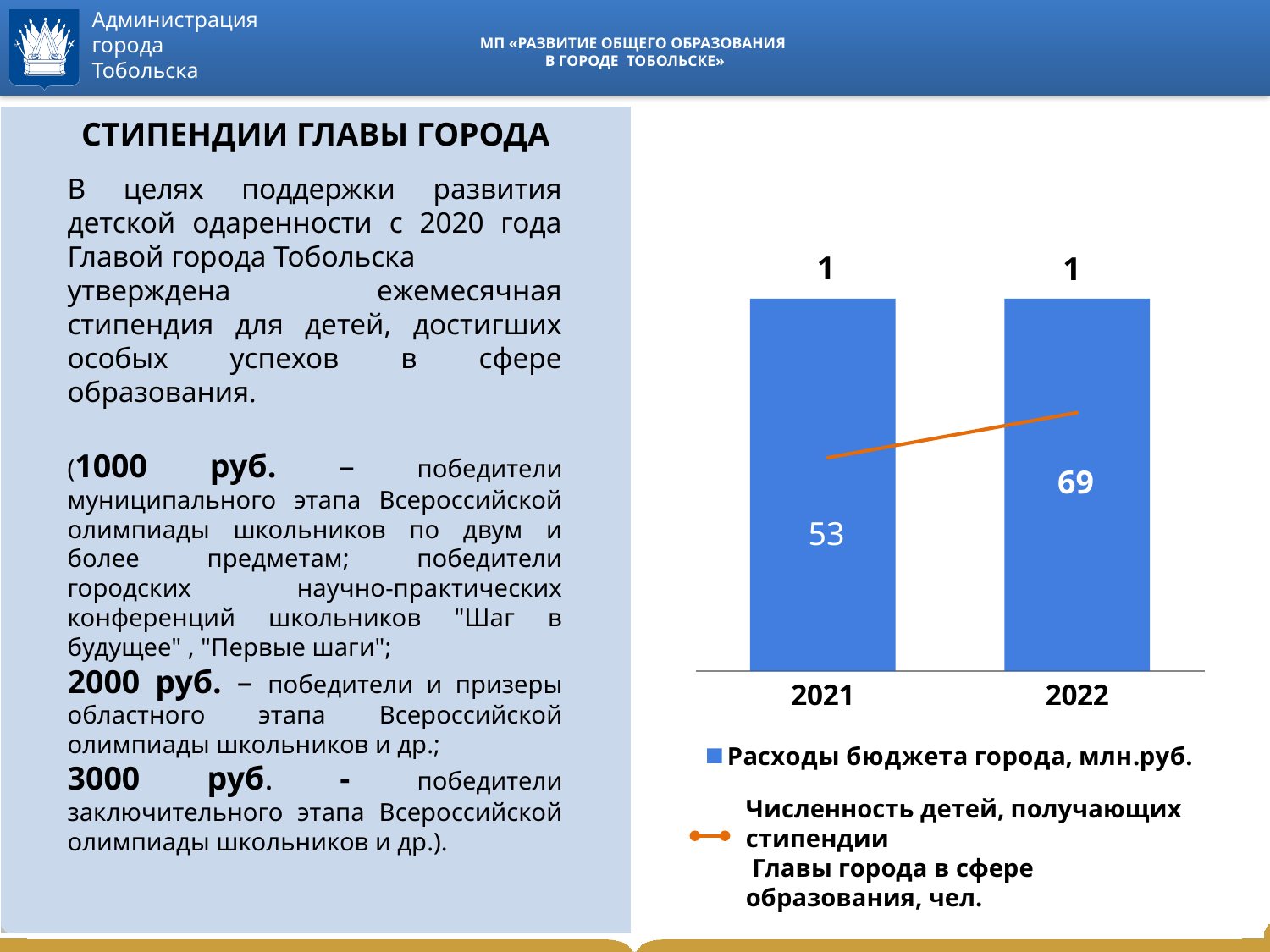
Does the number of children receiving scholarships rise or fall from 2021 to 2022? rise In which year was the number of children receiving scholarships highest? 2022 By how much did the number of children receiving scholarships increase from 2021 to 2022? 16 What is the value of 'Расходы бюджета города, млн.руб.' for 2022? 1 Which year has the larger number of children receiving scholarships, 2021 or 2022? 2022 How many series does the chart legend list? 2 In which year was the number of children receiving scholarships lowest? 2021 How many children received the Head of City scholarship in 2022 according to the chart? 69 How many years (categories) are shown on the x axis of the chart? 2 How many children received the Head of City scholarship in 2021 according to the chart? 53 What is the value of 'Расходы бюджета города, млн.руб.' for 2021? 1 What colour are the bars representing 'Расходы бюджета города, млн.руб.'? blue